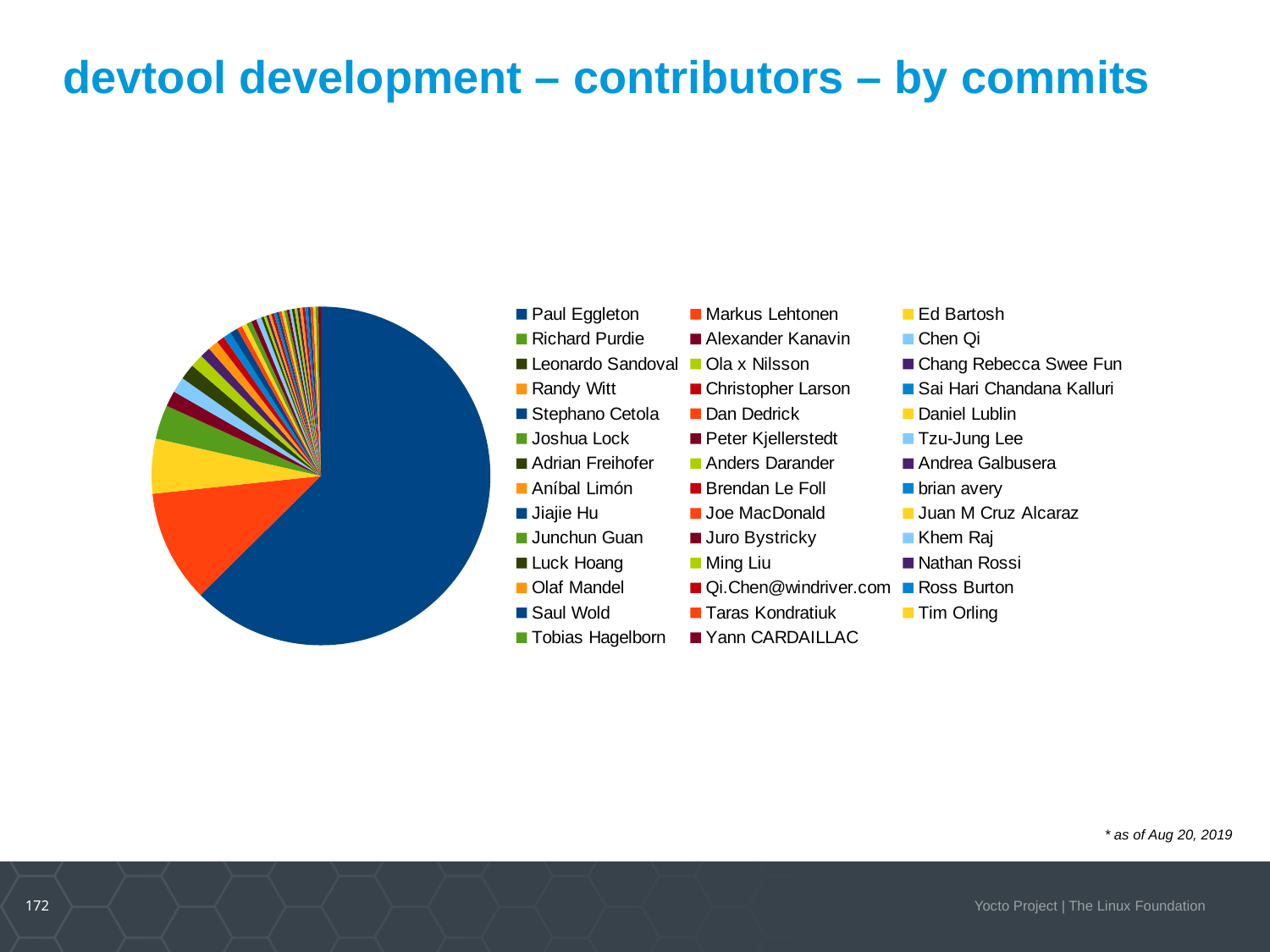
What is the title of the slide containing the chart? devtool development – contributors – by commits Which contributor has the largest slice of the pie? Paul Eggleton What kind of chart is shown on the slide? pie chart Which slice is larger, Paul Eggleton's or Markus Lehtonen's? Paul Eggleton How many contributors are listed in the legend? 41 Does Paul Eggleton's slice cover more or less than half of the pie? more Which slice is larger, Ed Bartosh's or Richard Purdie's? Ed Bartosh Which slice is larger, Markus Lehtonen's or Ed Bartosh's? Markus Lehtonen